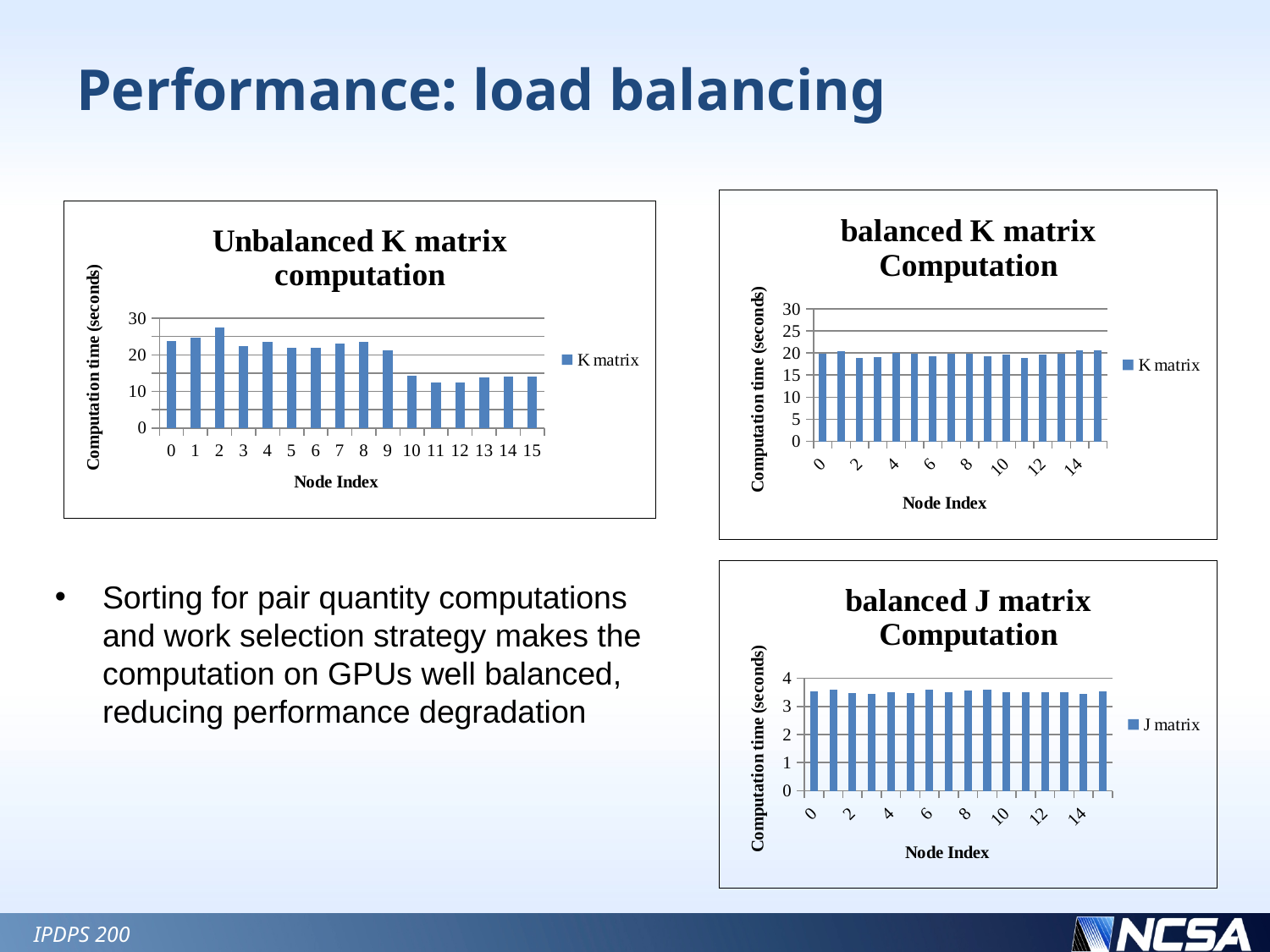
In the 'balanced K matrix Computation' chart, is the value for node 0 greater or less than 25? less In the 'Unbalanced K matrix computation' chart, which has the larger computation time, node 0 or node 10? node 0 In the 'balanced J matrix Computation' chart, is the value for node 0 greater or less than 3? greater In the 'Unbalanced K matrix computation' chart, how many node indices are shown on the x axis? 16 In the 'Unbalanced K matrix computation' chart, is the value for node 2 greater or less than 20? greater In the 'Unbalanced K matrix computation' chart, do the values from node 8 to node 11 rise or fall? fall What is the y-axis title of the 'balanced J matrix Computation' chart? Computation time (seconds) In the 'Unbalanced K matrix computation' chart, which node index has the highest computation time? 2 How many series does the legend of the 'balanced J matrix Computation' chart list? 1 What kind of chart is the 'Unbalanced K matrix computation' chart? bar chart